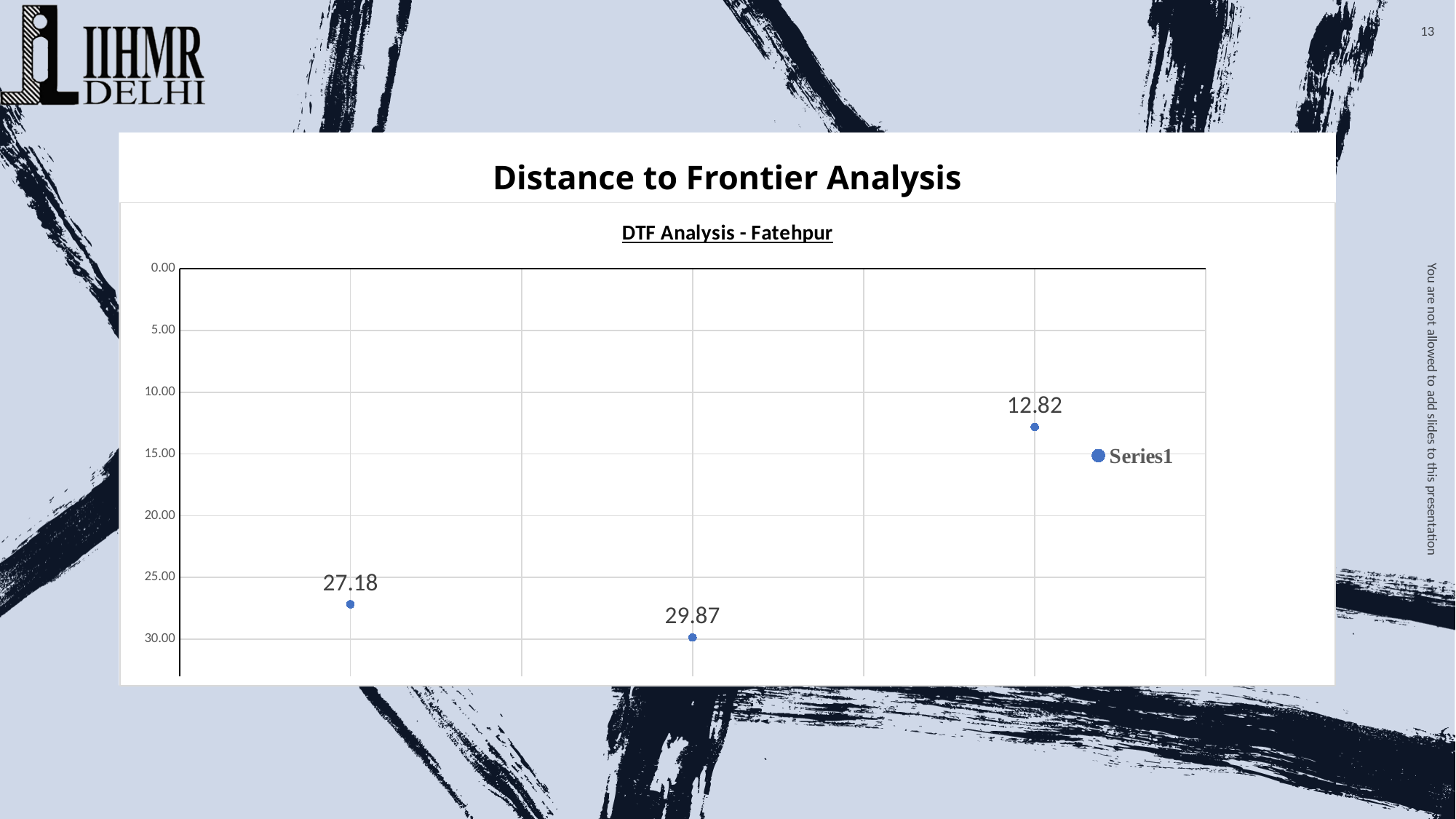
What kind of chart is shown on the slide? scatter chart What is the title of the chart? DTF Analysis - Fatehpur What is the name of the series shown in the legend? Series1 How many series does the legend list? 1 What is the lowest value plotted in the chart? 12.82 What is the value of the rightmost data point? 12.82 What is the difference between the middle data point (29.87) and the leftmost data point (27.18)? 2.69 What is the value of the leftmost data point? 27.18 How many data points are plotted in the chart? 3 What is the highest value plotted in the chart? 29.87 Which is larger, the value of the leftmost data point or the value of the rightmost data point? the leftmost data point (27.18) What is the value of the middle data point? 29.87